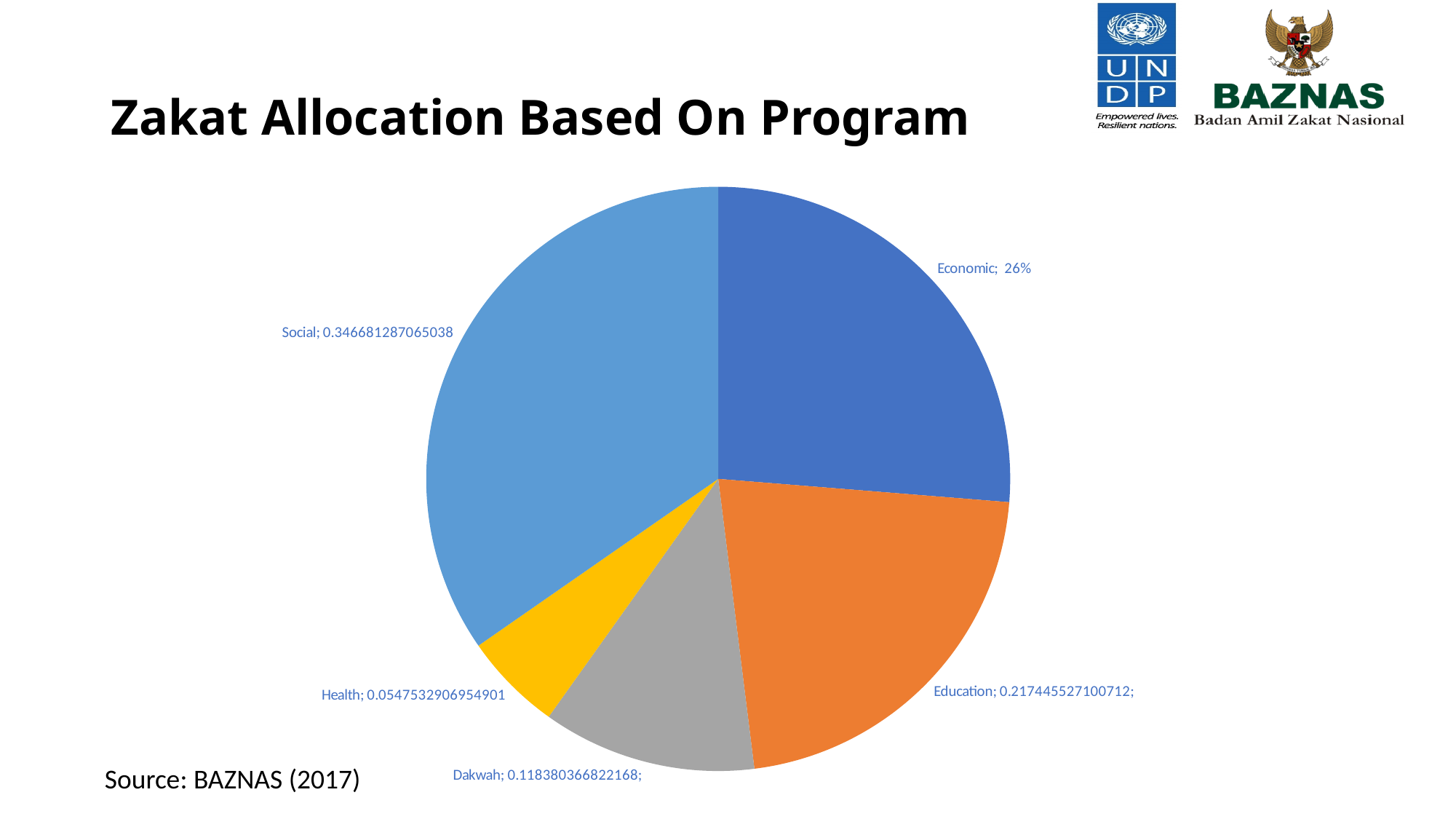
What is the source cited for the chart data? BAZNAS (2017) Which slice is larger, Education or Dakwah? Education What value is shown for the Social slice? 0.346681287065038 Which program has the smallest share of the pie? Health What value is shown for the Economic slice? 26% What is the title of the chart? Zakat Allocation Based On Program Which program has the largest share of the pie? Social What value is shown for the Education slice? 0.217445527100712 What value is shown for the Health slice? 0.0547532906954901 What kind of chart is shown on the slide? Pie chart How many slices does the pie chart have? 5 What value is shown for the Dakwah slice? 0.118380366822168